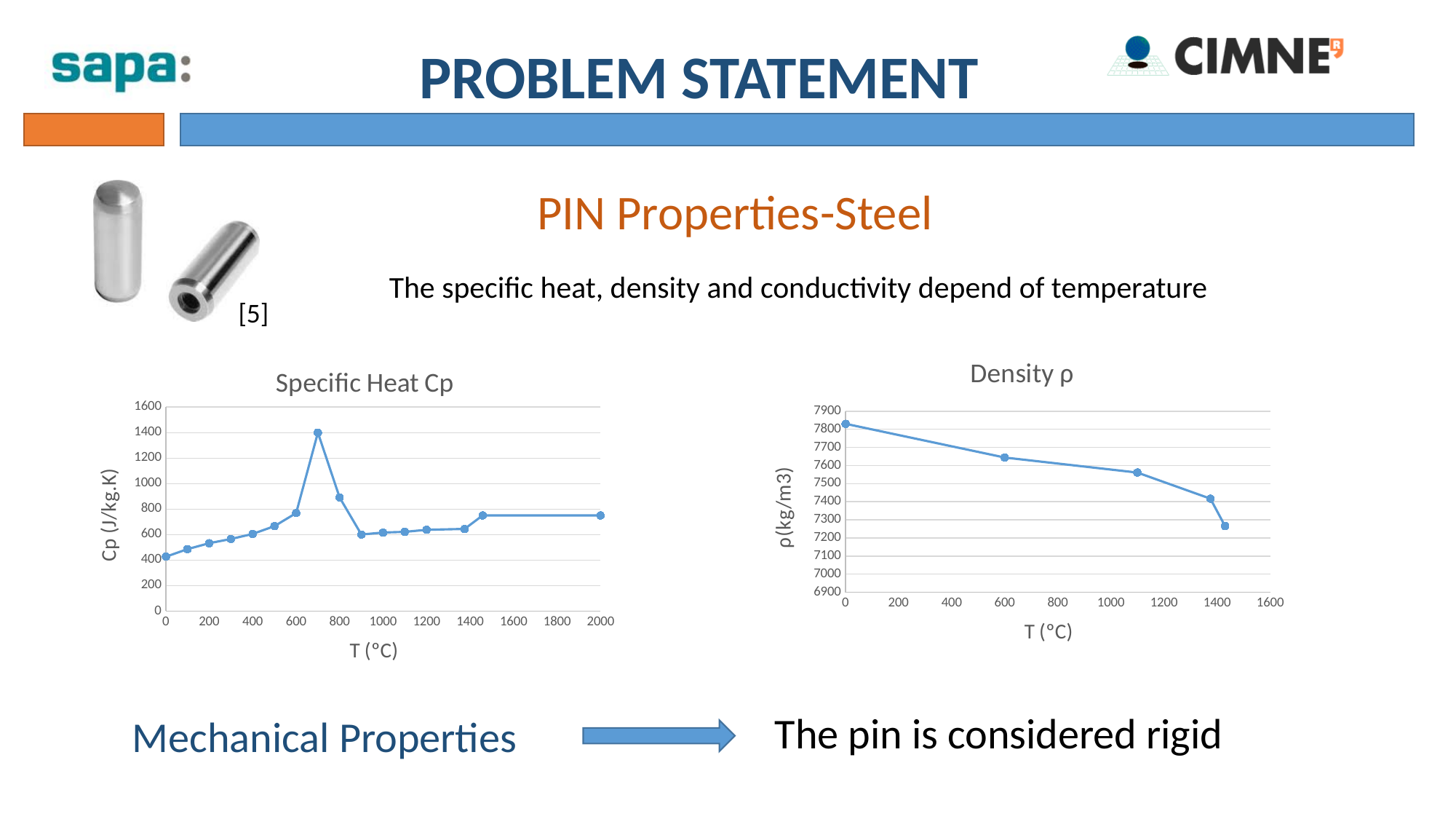
In the Specific Heat Cp chart, which is larger, the value at 700 °C or the value at 1000 °C? 700 °C In the Density ρ chart, is the value at 0 °C greater or less than 7700? greater In the Specific Heat Cp chart, is the value at 2000 °C greater or less than 1000? less In the Density ρ chart, at which temperature is the density highest? 0 °C In the Density ρ chart, do the values rise or fall as temperature increases? fall How many data points are plotted in the Density ρ chart? 5 What kind of chart is the Specific Heat Cp chart? line chart In the Specific Heat Cp chart, at which temperature does the specific heat reach its highest value? 700 °C What is the y-axis label of the Density ρ chart? ρ(kg/m3) What kind of chart is the Density ρ chart? line chart In the Specific Heat Cp chart, is the value at 700 °C greater or less than 1200? greater